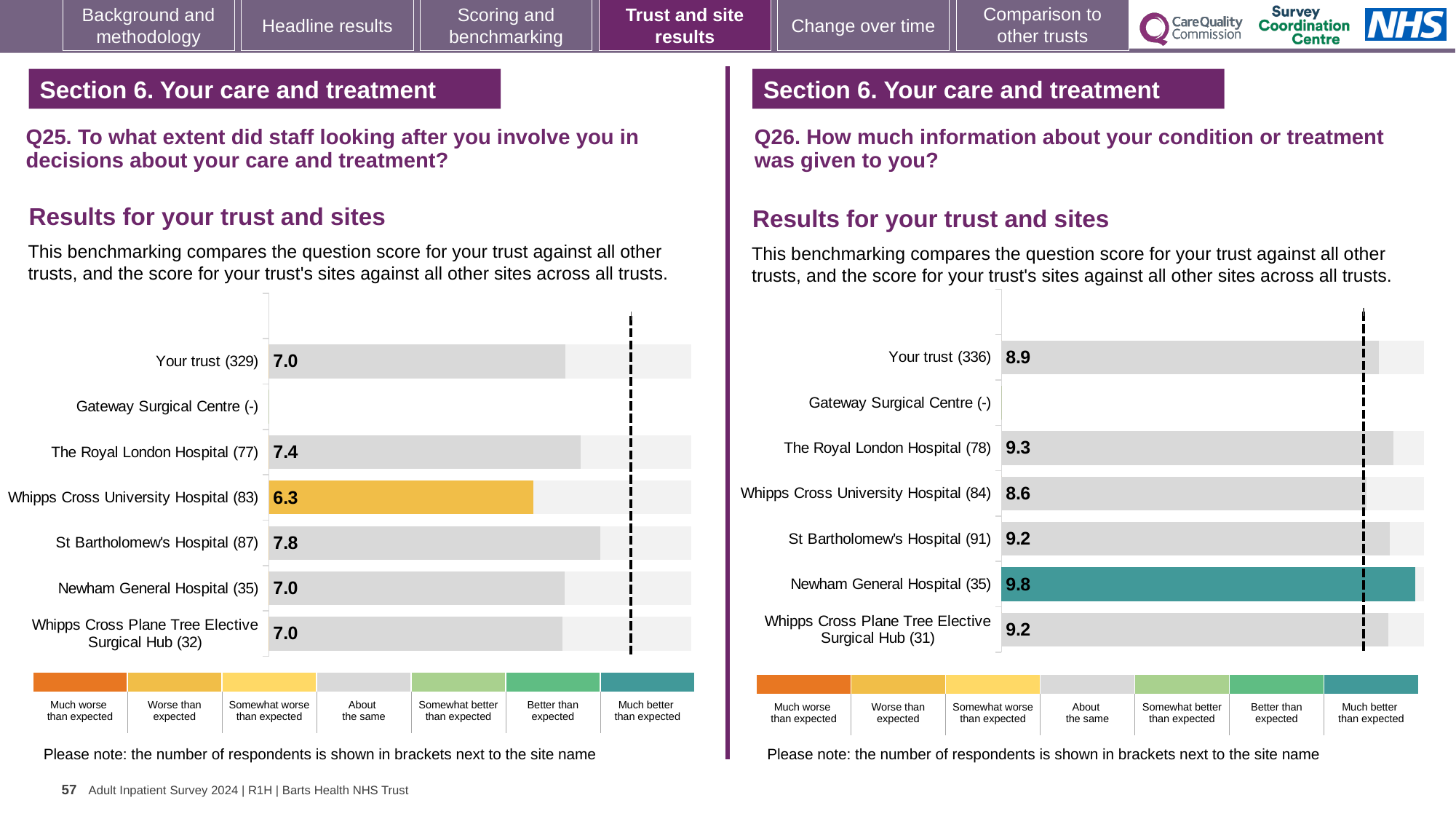
How many categories are listed on the Q25 chart (left)? 7 On the Q25 chart (left), what is the score for The Royal London Hospital? 7.4 On the Q26 chart (right), what is the difference between the scores for Newham General Hospital and Your trust? 0.9 On the Q26 chart (right), which has the larger score, The Royal London Hospital or St Bartholomew's Hospital? The Royal London Hospital On the Q25 chart (left), which site has the lowest score? Whipps Cross University Hospital What kind of chart is used on the Q26 chart (right)? Bar chart On the Q26 chart (right), which site has the lowest score? Whipps Cross University Hospital On the Q25 chart (left), what is the difference between the scores for St Bartholomew's Hospital and Whipps Cross University Hospital? 1.5 On the Q26 chart (right), which site has the highest score? Newham General Hospital On the Q25 chart (left), what is the score for Whipps Cross University Hospital? 6.3 On the Q26 chart (right), what is the score for Your trust? 8.9 On the Q25 chart (left), which site has the highest score? St Bartholomew's Hospital